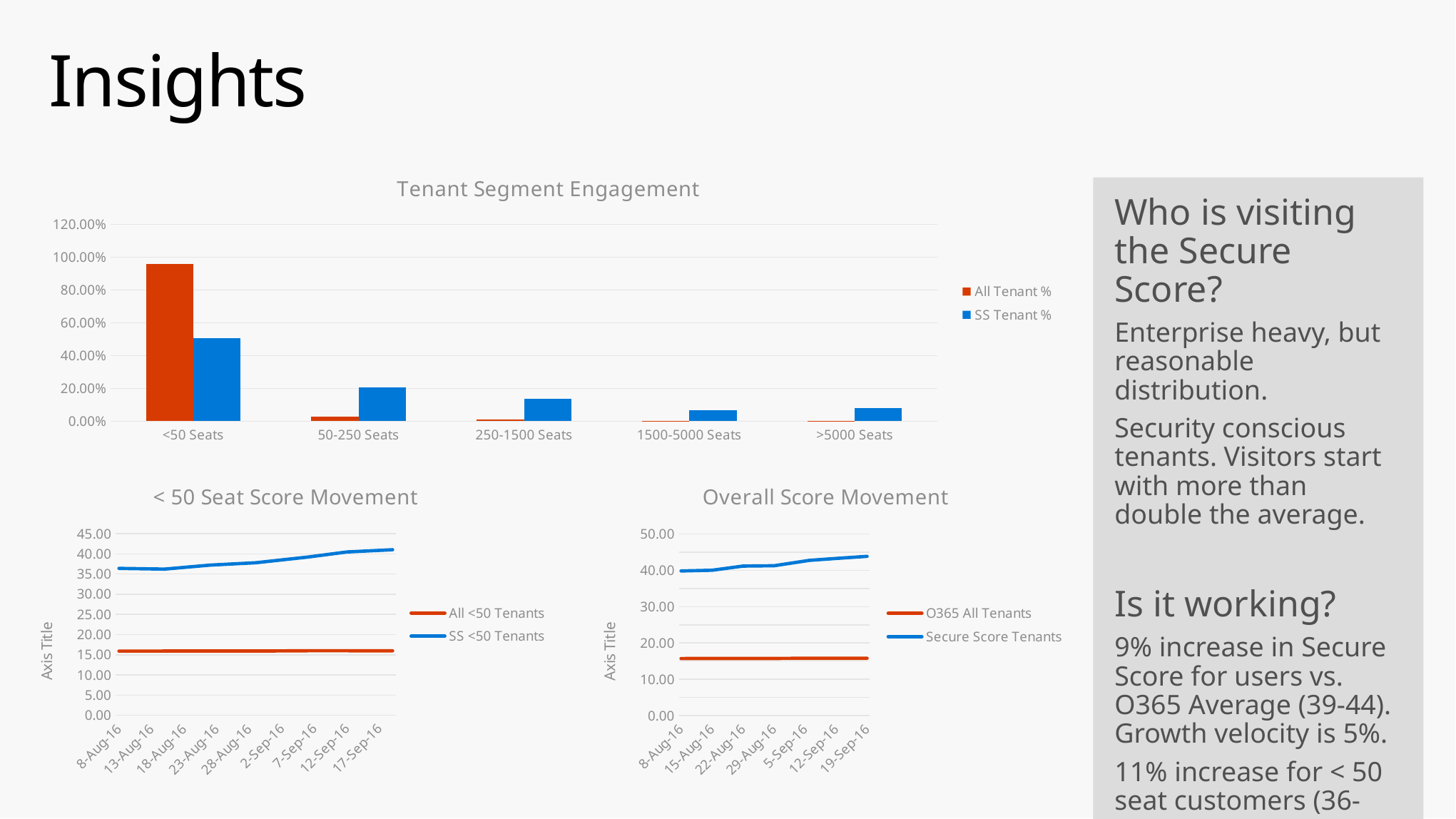
How many seat-size categories does the Tenant Segment Engagement chart show? 5 How many series does the legend of the Tenant Segment Engagement chart list? 2 In the Overall Score Movement chart, is the O365 All Tenants value on 19-Sep-16 greater or less than 20.00? less In the Tenant Segment Engagement chart, is the SS Tenant % value for 250-1500 Seats greater or less than 20.00%? less In the Tenant Segment Engagement chart, for <50 Seats, which is larger: All Tenant % or SS Tenant %? All Tenant % What kind of chart is the < 50 Seat Score Movement chart? line chart In the < 50 Seat Score Movement chart, does the SS <50 Tenants line rise or fall from 8-Aug-16 to 17-Sep-16? rise In the Tenant Segment Engagement chart, is the All Tenant % value for <50 Seats greater or less than 80.00%? greater In the Tenant Segment Engagement chart, for 50-250 Seats, which is larger: All Tenant % or SS Tenant %? SS Tenant % In the Tenant Segment Engagement chart, which category has the highest SS Tenant % value? <50 Seats What kind of chart is the Tenant Segment Engagement chart? bar chart